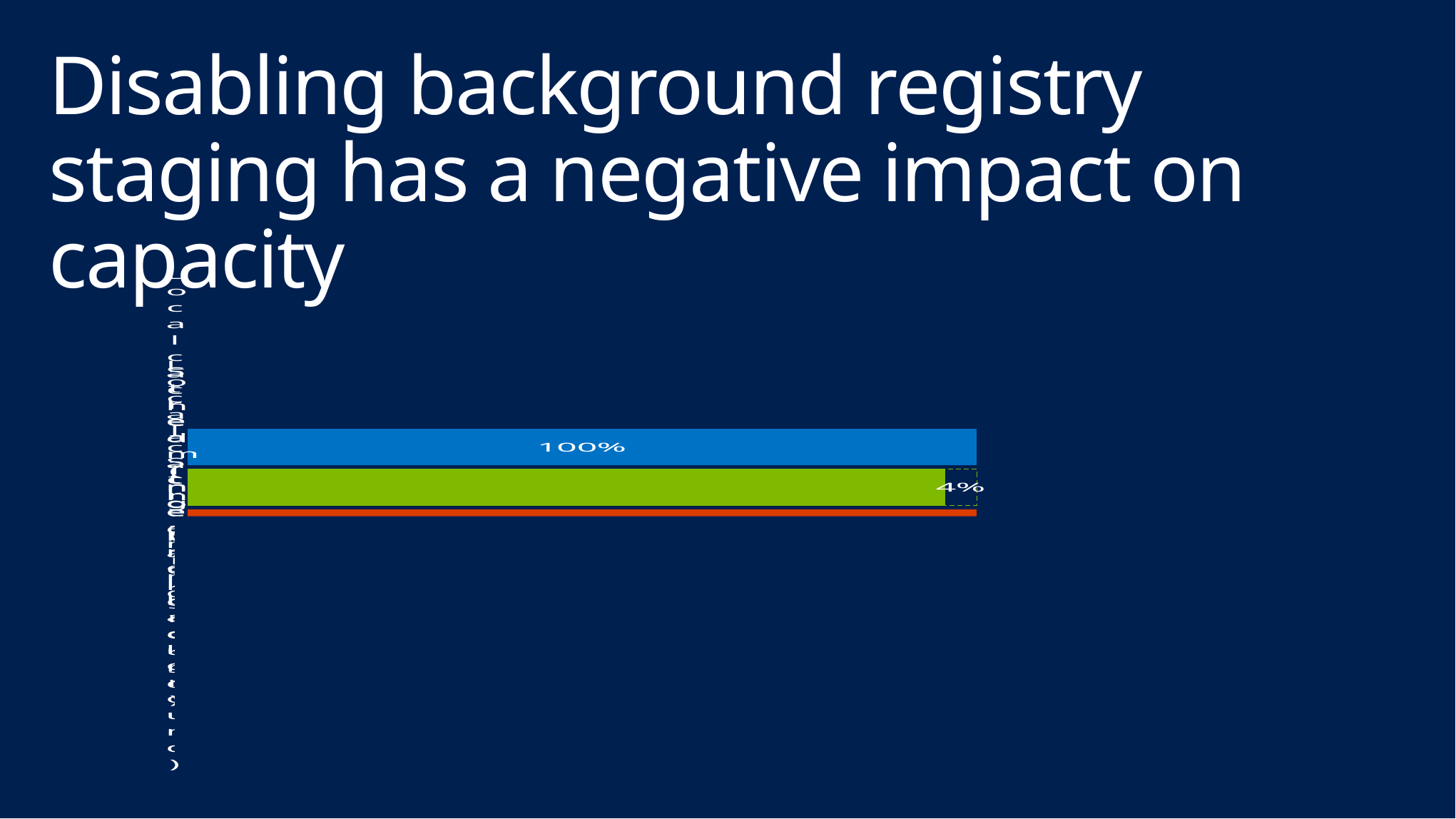
What colour is the bar directly below the 100% bar? green What colour is the top bar in the chart? blue What kind of chart is shown on the slide? bar chart Which bar shows the highest value? the blue bar (100%) Which bar is longer, the blue bar or the green bar? the blue bar What value is printed on the blue bar? 100% How many bars carry a printed data label? 2